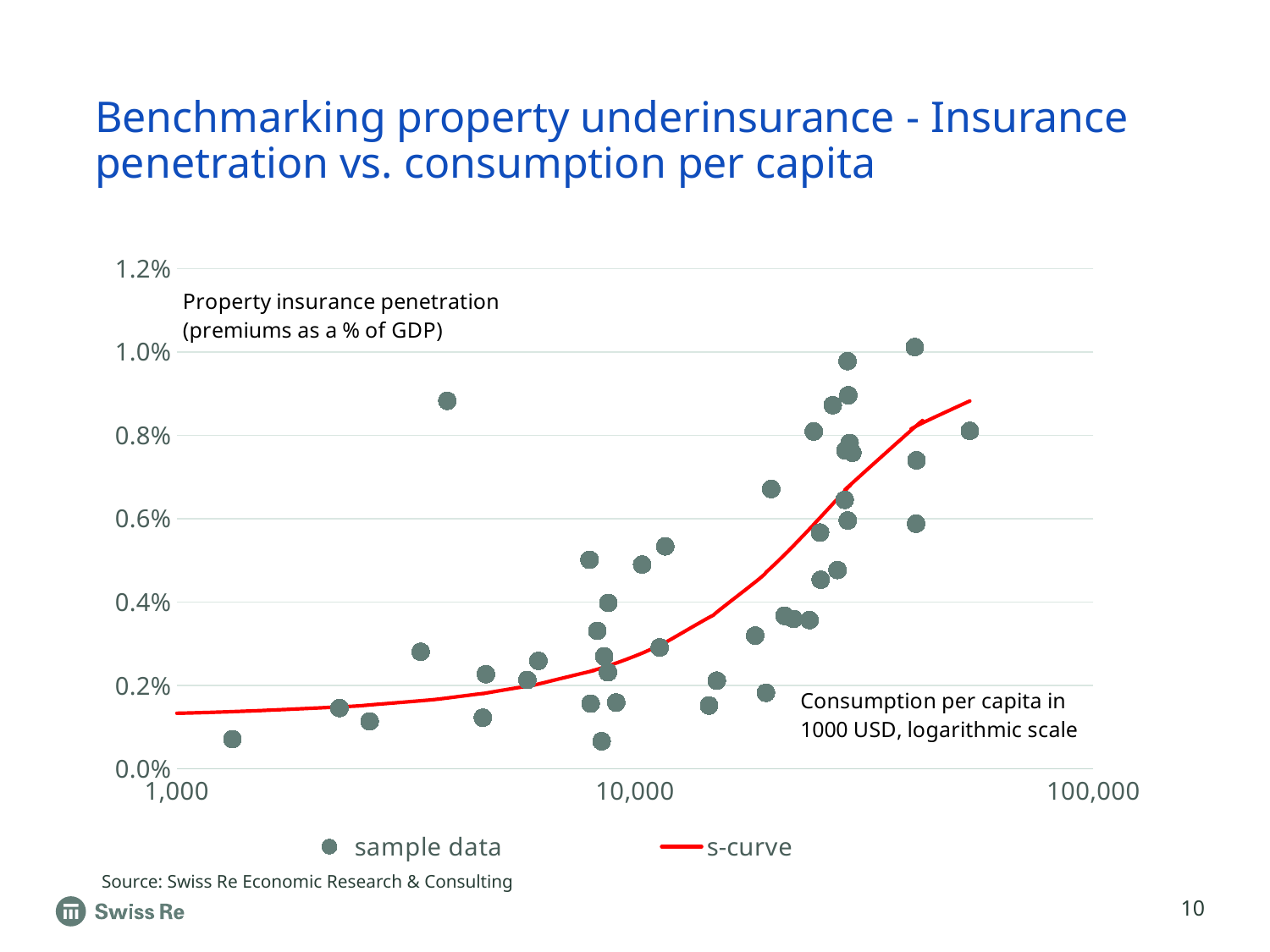
Does the s-curve rise or fall as consumption per capita increases along the x axis? rise What kind of chart is shown on the slide? scatter chart What does the vertical axis of the chart measure? Property insurance penetration (premiums as a % of GDP) What is the highest value shown on the vertical axis? 1.2% How many series does the legend list? 2 Is the value of the s-curve at a consumption per capita of 1,000 greater or less than 0.2%? less What are the two entries in the chart legend? sample data, s-curve What is the largest tick label shown on the horizontal axis? 100,000 Is the highest sample data point greater or less than 0.8%? greater Is the value of the s-curve at a consumption per capita of 10,000 greater or less than 0.6%? less